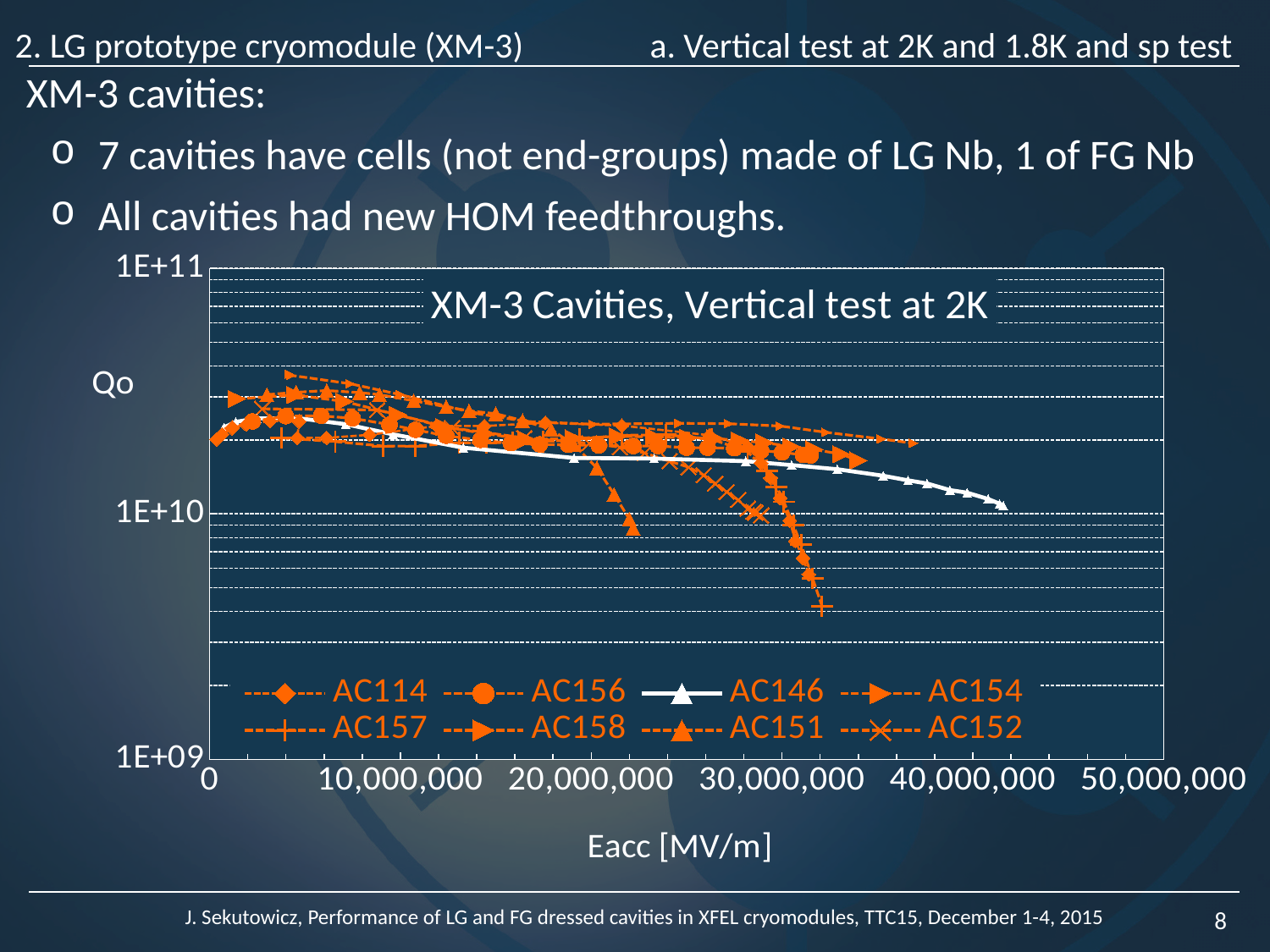
Is the highest Eacc value reached by the AC146 series greater or less than 40,000,000? greater What is the title of the chart? XM-3 Cavities, Vertical test at 2K What is the label of the x axis of the chart? Eacc [MV/m] Is the highest Eacc value reached by the AC154 series greater or less than 30,000,000? greater Does Qo generally rise or fall as Eacc increases along the x axis? fall Which series extends to the highest Eacc value on the chart? AC146 Is the lowest Qo value of the AC157 series greater or less than 1E+10? less What kind of chart is shown on the slide? line chart Which series reaches a higher Eacc value, AC146 or AC151? AC146 How many series does the chart legend list? 8